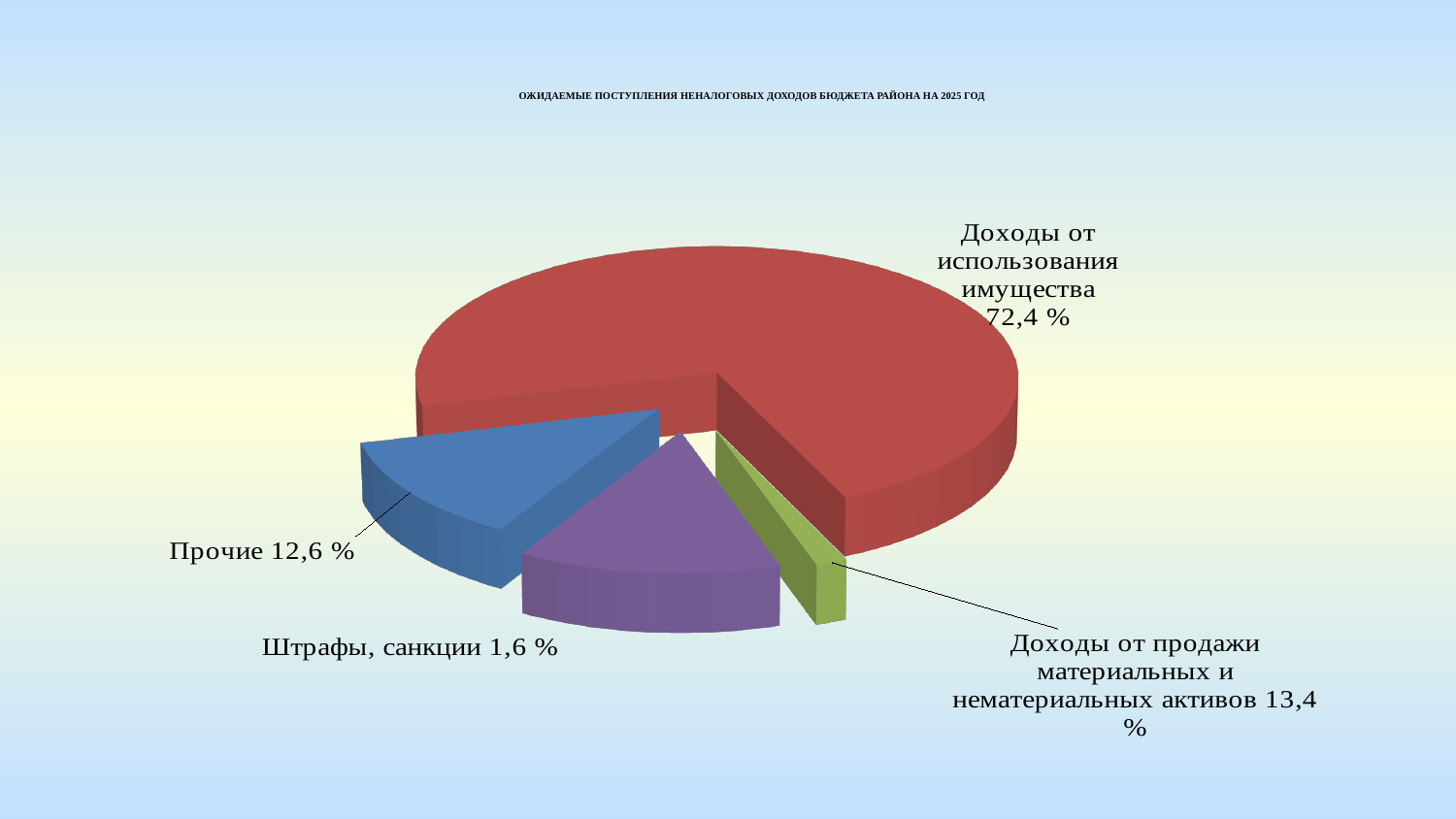
How many categories are shown in the pie chart? 4 What share of the pie is labelled for "Доходы от использования имущества"? 72,4 % Which category has the largest share of the pie? Доходы от использования имущества What value is shown for "Прочие"? 12,6 % What is the difference in percentage points between "Доходы от использования имущества" and "Прочие"? 59,8 What type of chart is shown on the slide? Pie chart What colour is the largest slice of the pie? Red What is the title of the chart on the slide? ОЖИДАЕМЫЕ ПОСТУПЛЕНИЯ НЕНАЛОГОВЫХ ДОХОДОВ БЮДЖЕТА РАЙОНА НА 2025 ГОД What value is shown for "Доходы от продажи материальных и нематериальных активов"? 13,4 % What value is shown for "Штрафы, санкции"? 1,6 % Which category has the smallest share of the pie? Штрафы, санкции Which is larger: the share for "Прочие" or the share for "Доходы от продажи материальных и нематериальных активов"? Доходы от продажи материальных и нематериальных активов